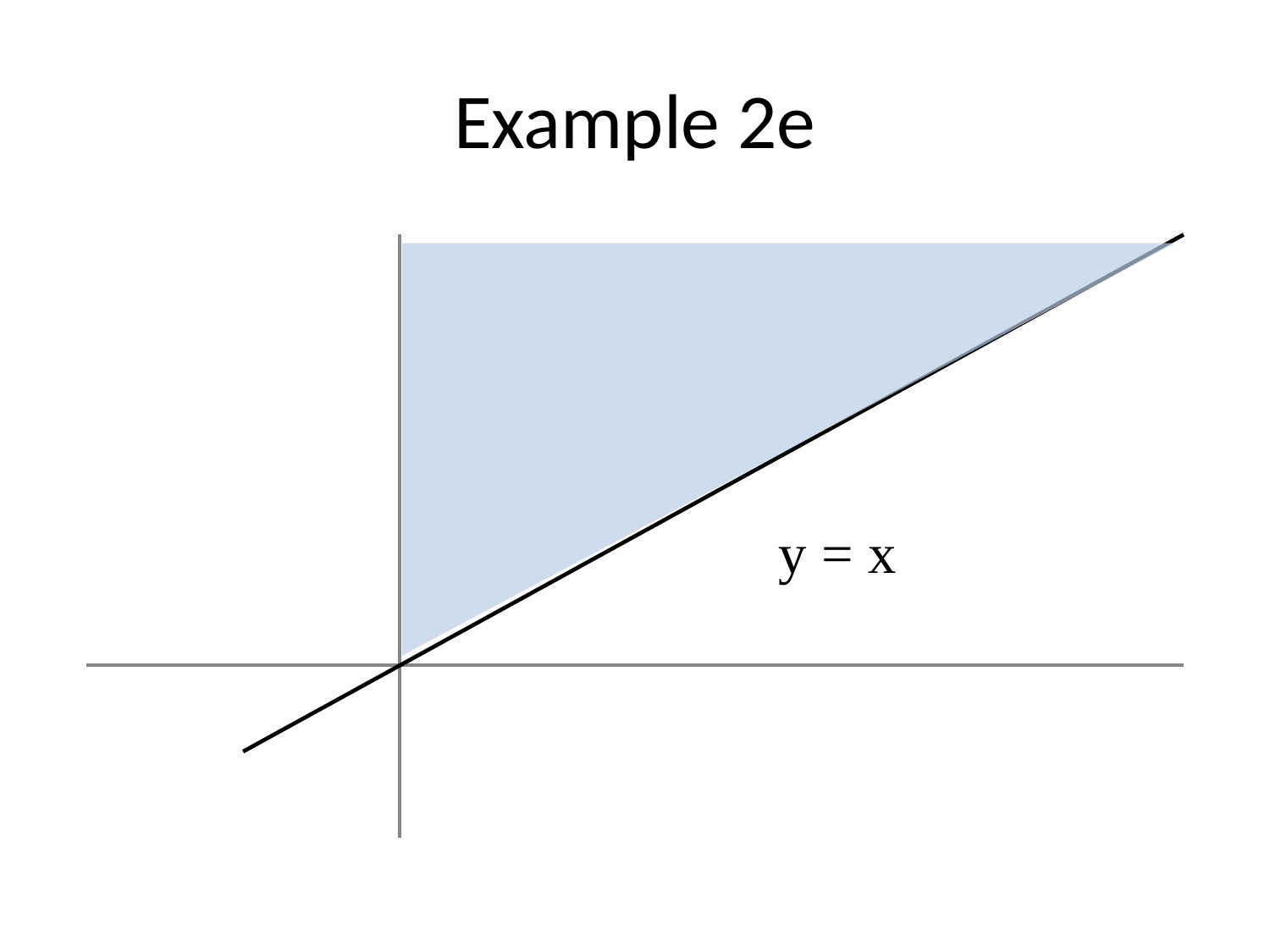
Does the line y = x rise or fall as x increases? rises What is the title of the slide containing the graph? Example 2e What is the equation of the line drawn on the graph? y = x